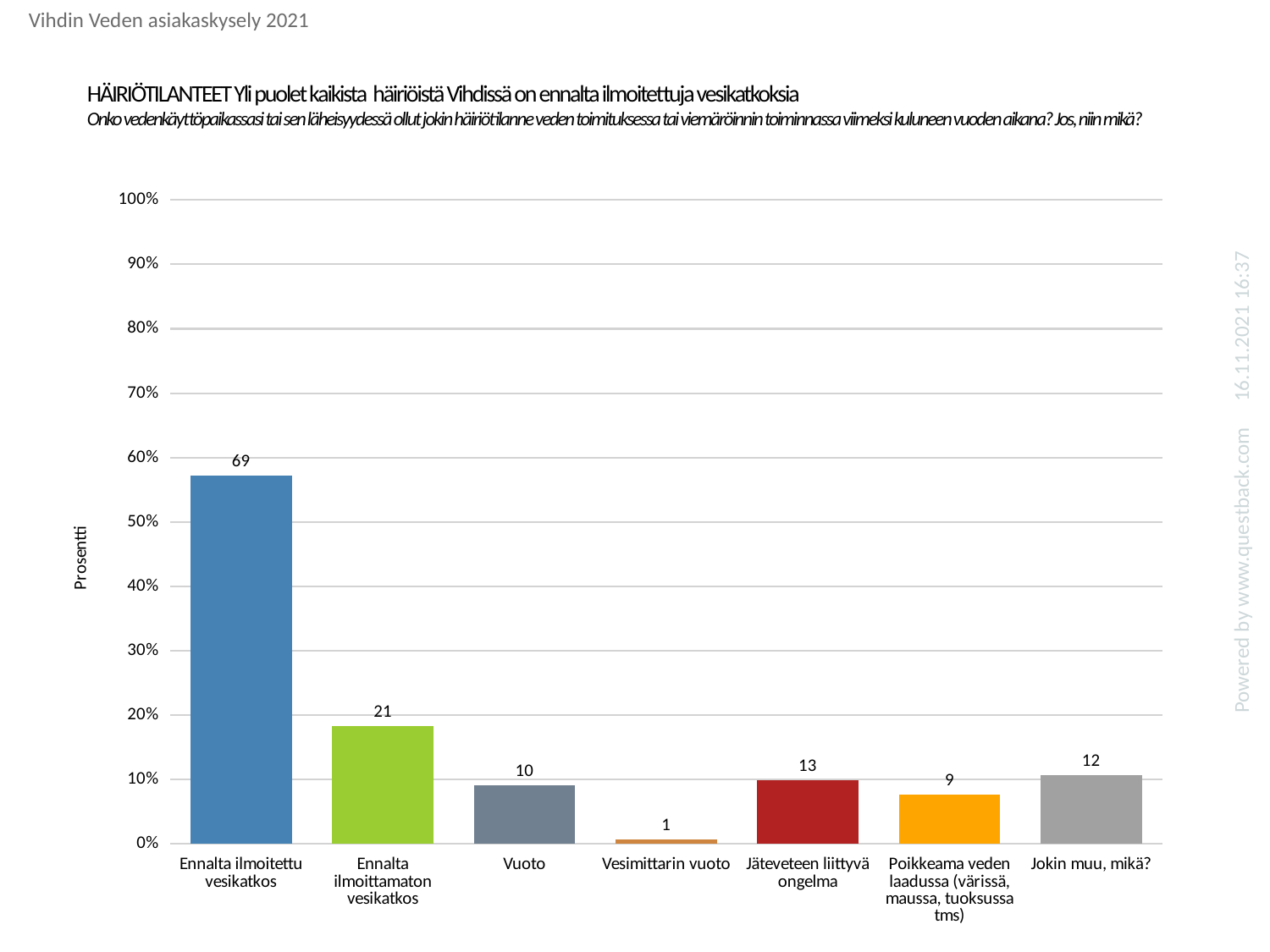
Is the value for Ennalta ilmoittamaton vesikatkos greater or less than 20%? less Which category has the highest bar? Ennalta ilmoitettu vesikatkos Is the value for Ennalta ilmoitettu vesikatkos greater or less than 50%? greater Which bar is taller: Jäteveteen liittyvä ongelma or Poikkeama veden laadussa? Jäteveteen liittyvä ongelma What kind of chart is shown on the slide? bar chart How many categories are shown on the x axis? 7 What is the data label shown above the bar for Jäteveteen liittyvä ongelma? 13 What is the data label shown above the bar for Vuoto? 10 Which category has the lowest bar? Vesimittarin vuoto What is the label of the y axis? Prosentti What is the data label shown above the bar for Ennalta ilmoittamaton vesikatkos? 21 What is the difference between the data labels for Ennalta ilmoitettu vesikatkos and Ennalta ilmoittamaton vesikatkos? 48